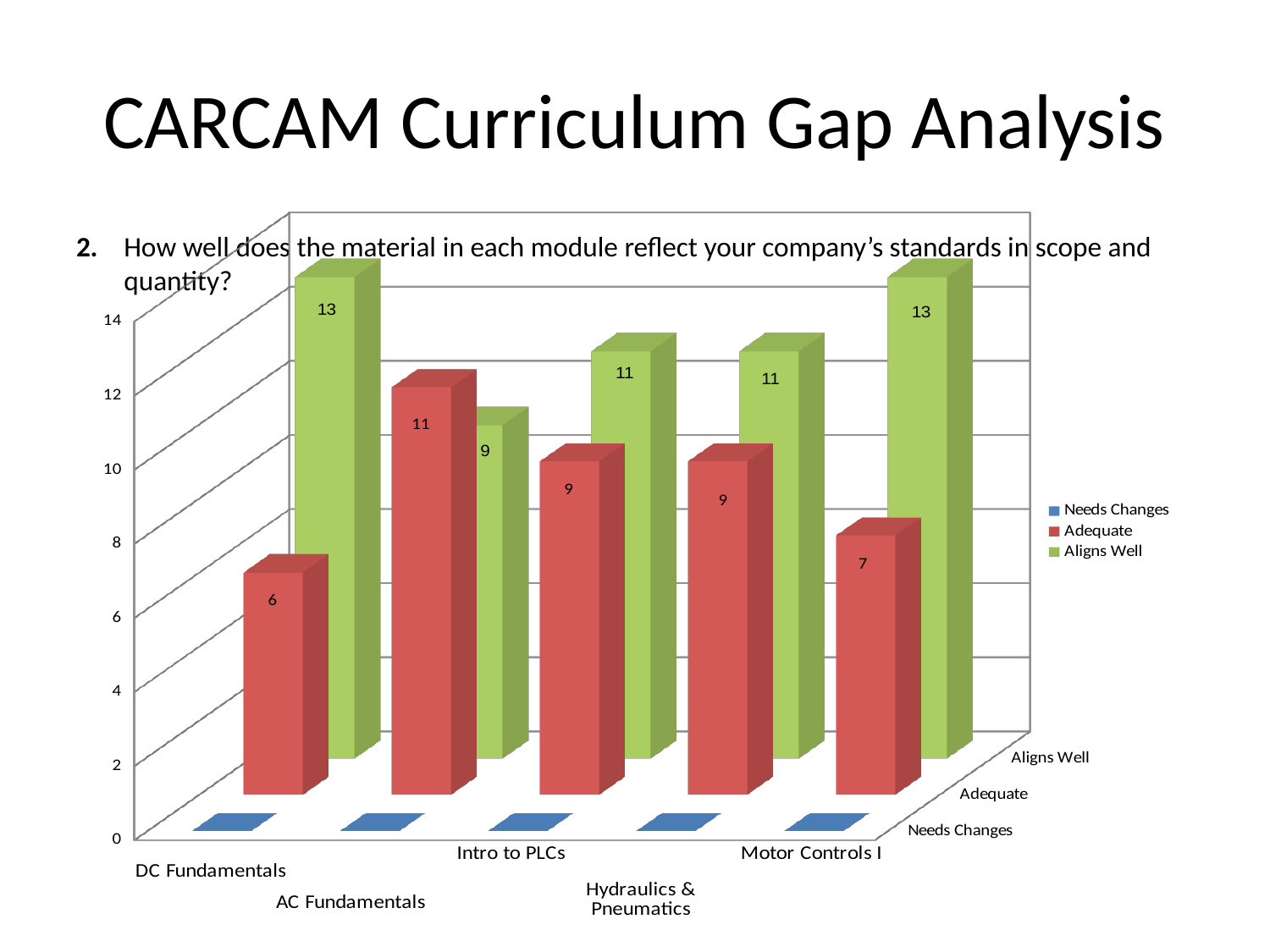
What is the Aligns Well value for Intro to PLCs? 11 For AC Fundamentals, which is larger: the Adequate value or the Aligns Well value? Adequate How many series does the legend list? 3 What kind of chart is shown on the slide? Bar chart What is the Aligns Well value for AC Fundamentals? 9 How many modules (categories) are shown on the chart? 5 Which module has the lowest Aligns Well value? AC Fundamentals Which module has the lowest Adequate value? DC Fundamentals What is the difference between the Aligns Well and Adequate values for DC Fundamentals? 7 What is the Adequate value for Motor Controls I? 7 Which module has the highest Adequate value? AC Fundamentals What is the Adequate value for DC Fundamentals? 6